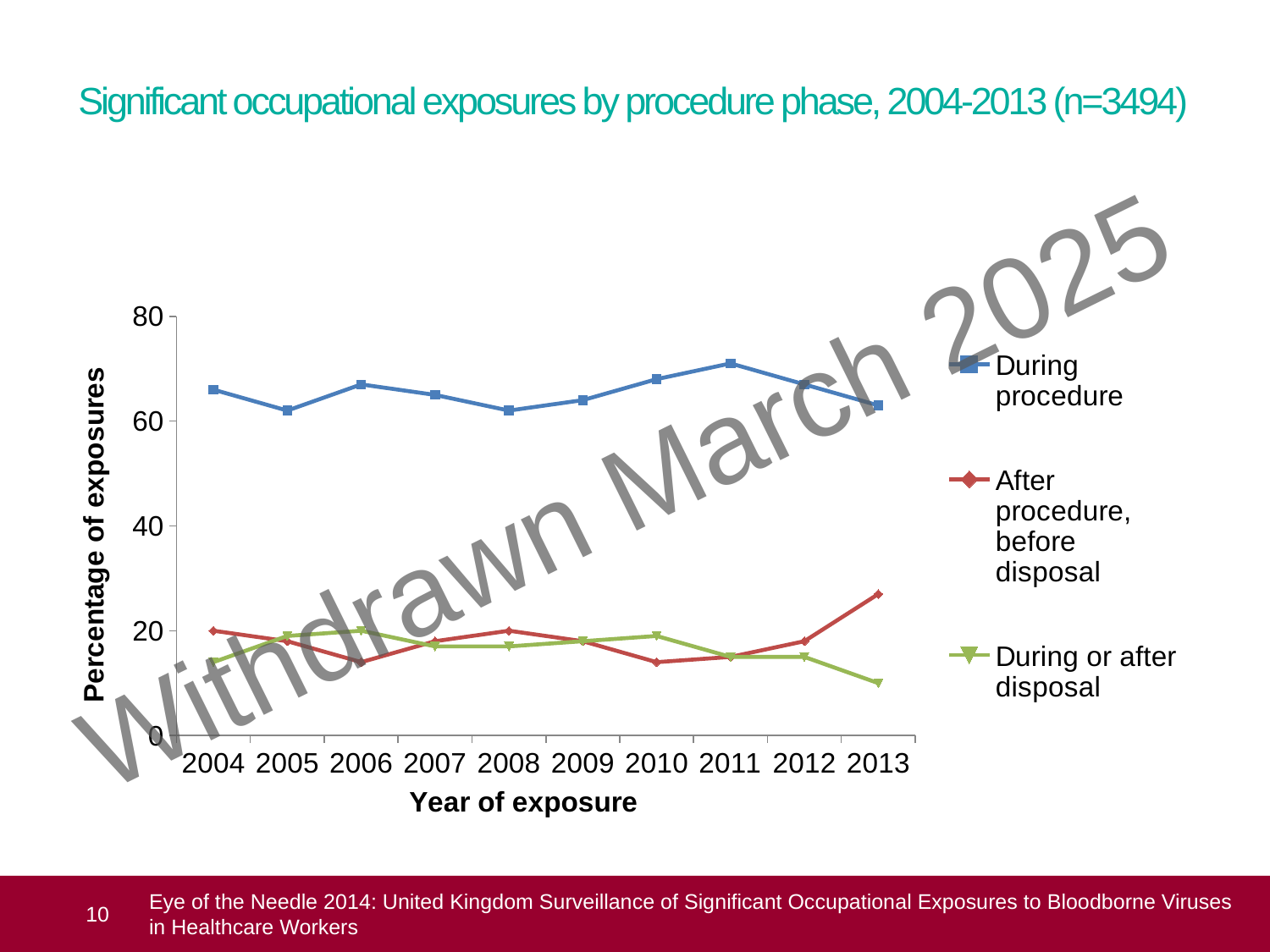
Is the value for During or after disposal in 2013 greater or less than 20? less What is the label of the y axis? Percentage of exposures How many series does the legend list? 3 Is the value for During procedure in 2004 greater or less than 60? greater In which year is the During procedure series at its highest? 2011 In which year is the During or after disposal series at its lowest? 2013 Does the During or after disposal series rise or fall from 2010 to 2013? fall In which year is the After procedure, before disposal series at its highest? 2013 What kind of chart is shown on the slide? line chart In 2013, which is larger: After procedure, before disposal or During or after disposal? After procedure, before disposal How many years are plotted along the x axis? 10 Is the value for After procedure, before disposal in 2013 greater or less than 20? greater